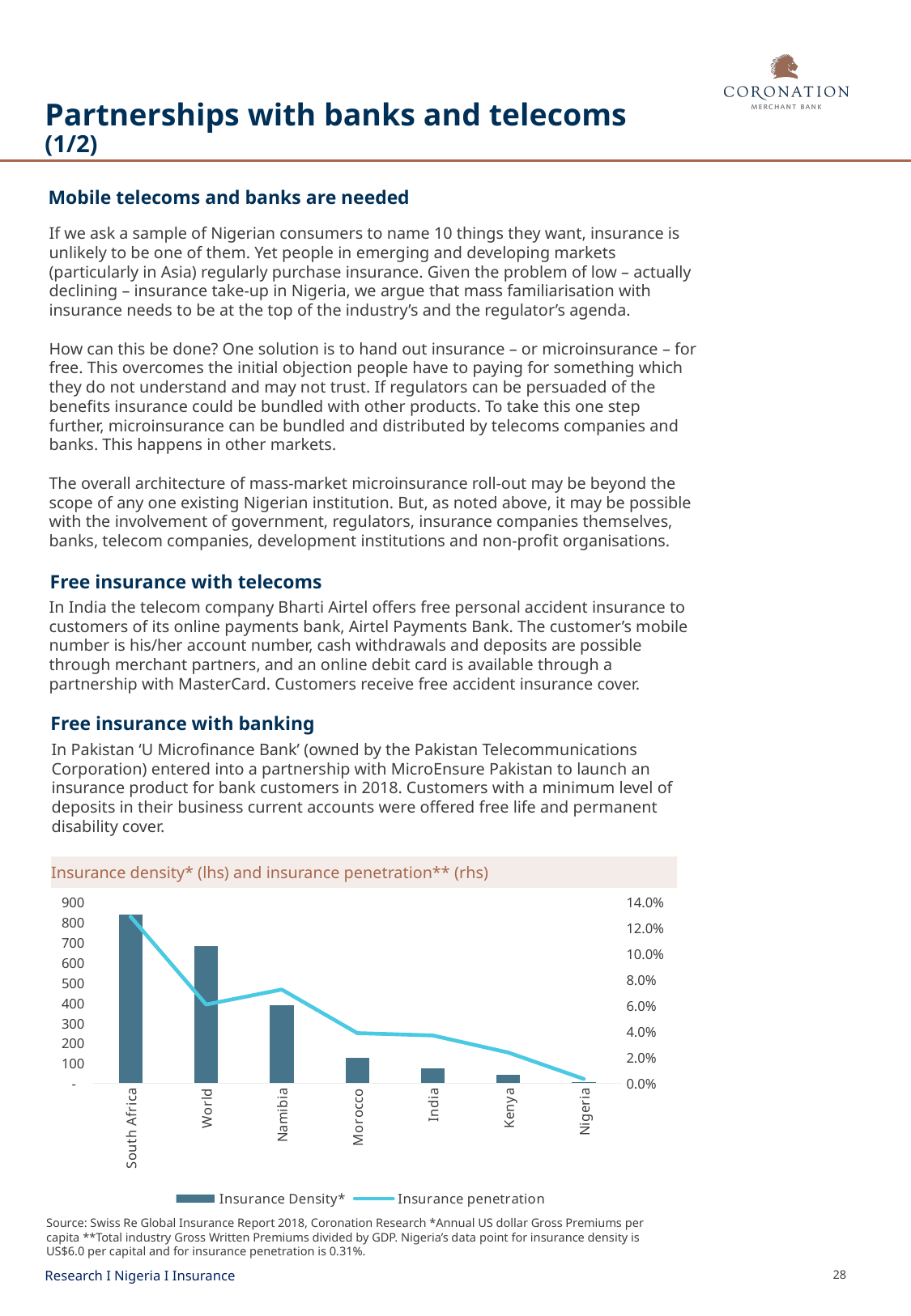
How many countries/regions are shown on the x axis of the chart? 7 Do the Insurance Density* bars generally rise or fall from left to right along the x axis? fall Which category has the lowest Insurance Density* bar? Nigeria Which has the higher Insurance penetration, Namibia or World? Namibia Which has the larger Insurance Density* bar, World or Namibia? World What kind of chart is shown on the slide? A combined bar and line chart Is the Insurance penetration value for South Africa greater or less than 12.0%? greater Is the Insurance Density* value for Morocco greater or less than 200? less Is the Insurance Density* value for South Africa greater or less than 700? greater How many series does the chart legend list? 2 Which category has the highest Insurance Density* bar? South Africa